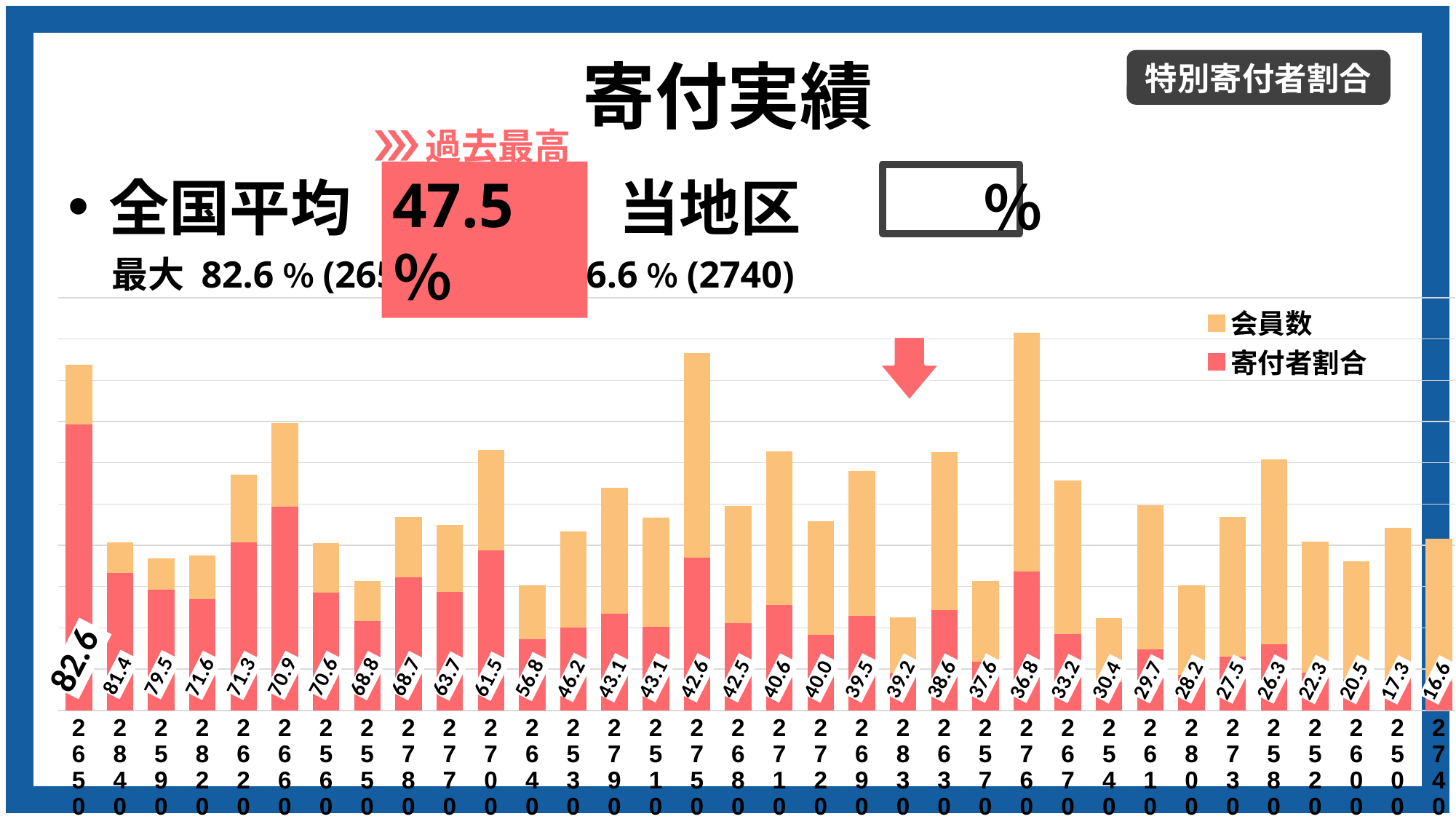
What is the 寄付者割合 value for district 2740? 16.6 Which district has the lowest 寄付者割合 value? 2740 Which district has a larger 寄付者割合 value, 2820 or 2760? 2820 What kind of chart is shown on the slide? Stacked bar chart Do the 寄付者割合 values rise or fall from left to right along the x axis? Fall What is the 寄付者割合 value for district 2760? 36.8 How many districts (bars) are shown in the chart? 34 What is the 寄付者割合 value for district 2500? 17.3 What is the 寄付者割合 value for district 2840? 81.4 How many series does the chart legend list? 2 What is the difference between the 寄付者割合 values for districts 2840 and 2590? 1.9 What is the highest 寄付者割合 value shown in the chart? 82.6